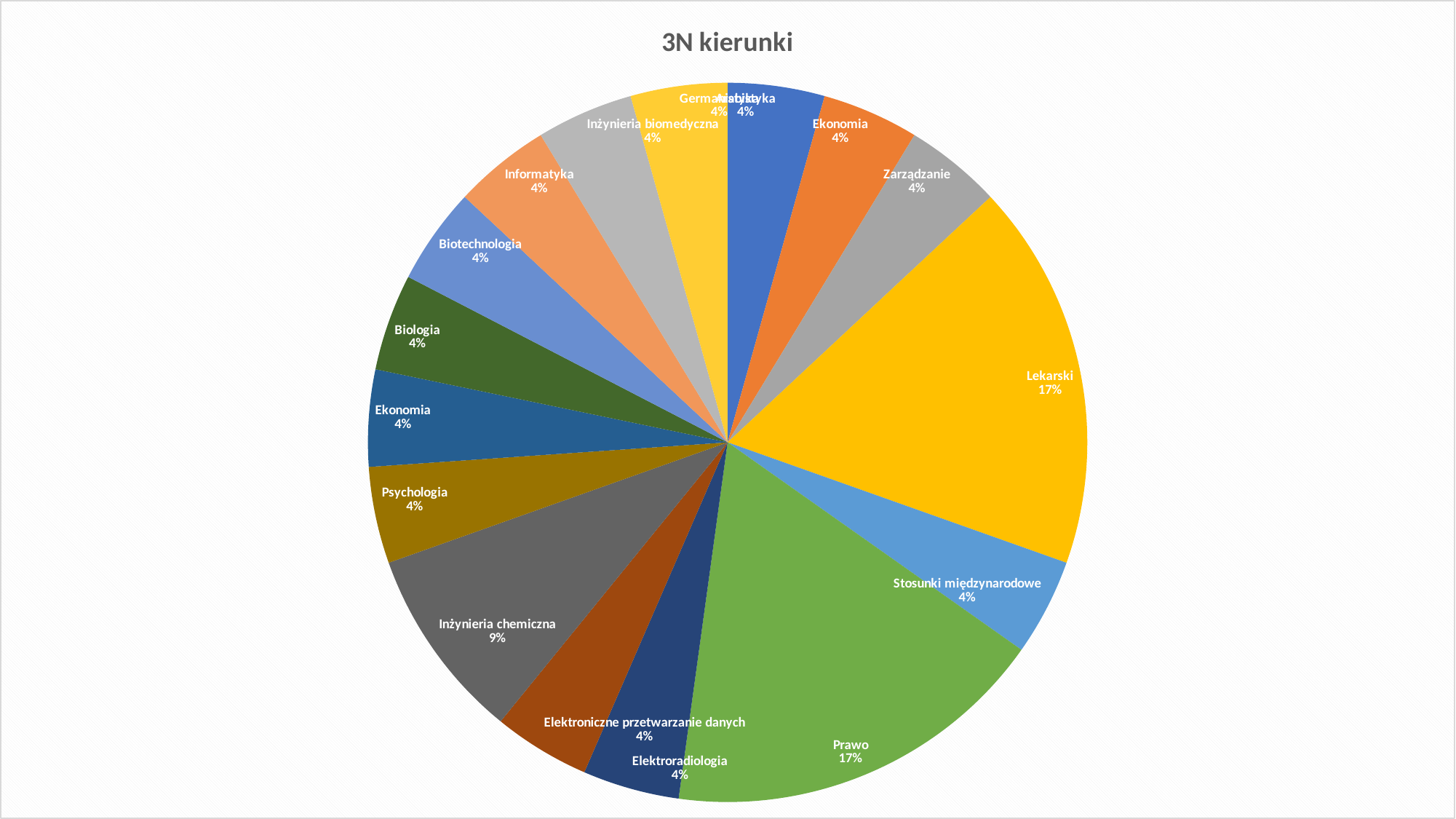
What percentage is shown for Elektroradiologia? 4% What percentage is shown for Stosunki międzynarodowe? 4% How many slices does the pie chart have? 16 What is the difference in percentage points between Lekarski and Inżynieria chemiczna? 8 percentage points What is the title of the chart? 3N kierunki What share of the pie does Lekarski have? 17% What percentage is shown for Inżynieria chemiczna? 9% What kind of chart is shown on the slide? pie chart Which slice is larger, Prawo or Zarządzanie? Prawo Which slice is larger, Inżynieria chemiczna or Biologia? Inżynieria chemiczna What percentage is shown for Prawo? 17% What percentage is shown for Psychologia? 4%